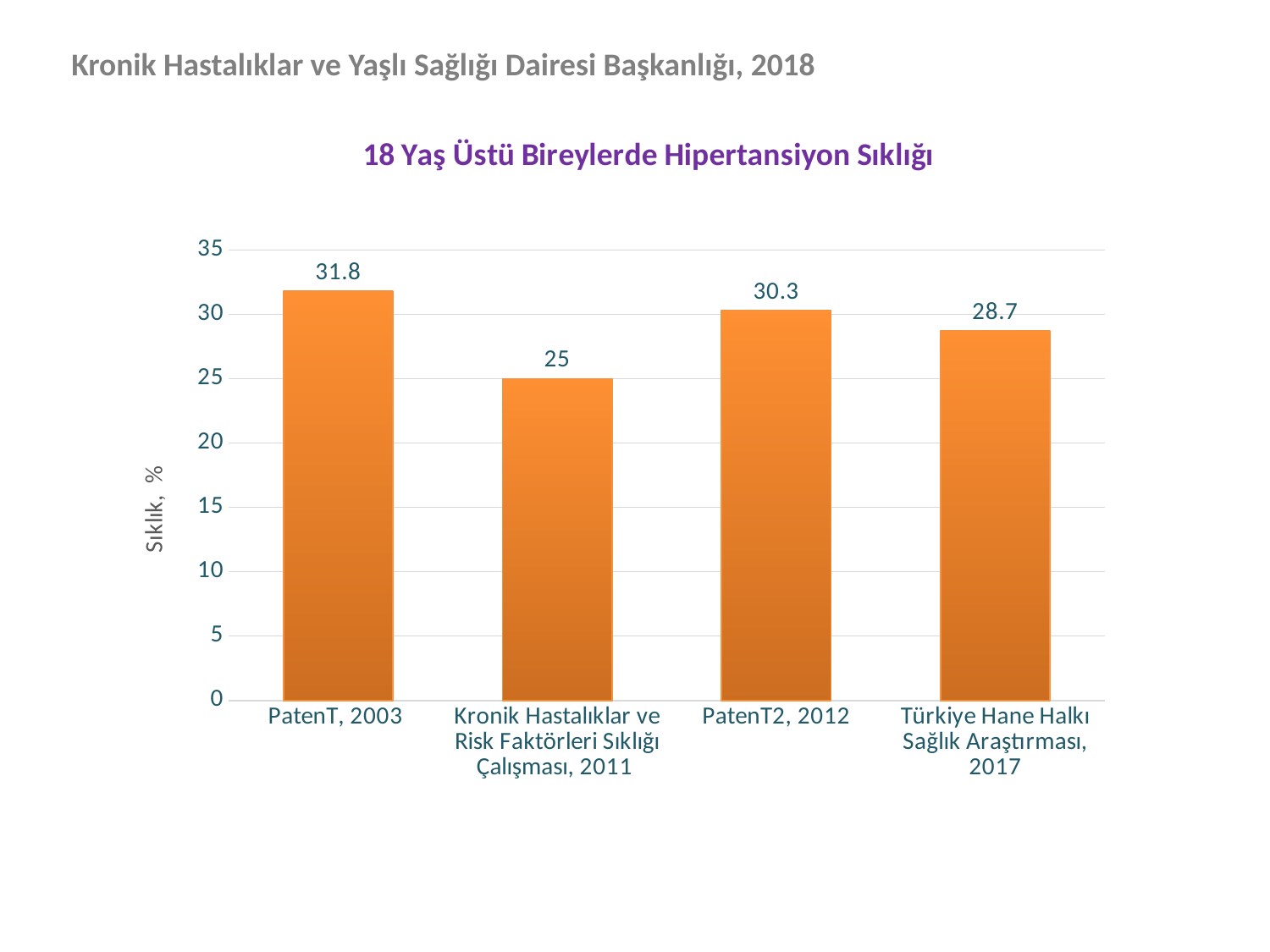
What is the value for Türkiye Hane Halkı Sağlık Araştırması, 2017? 28.7 Which is larger, the value for PatenT2, 2012 or the value for Türkiye Hane Halkı Sağlık Araştırması, 2017? PatenT2, 2012 What is the value for Kronik Hastalıklar ve Risk Faktörleri Sıklığı Çalışması, 2011? 25 What is the value for PatenT, 2003? 31.8 Which category has the highest value? PatenT, 2003 What is the title of the chart? 18 Yaş Üstü Bireylerde Hipertansiyon Sıklığı What kind of chart is shown on the slide? bar chart Which category has the lowest value? Kronik Hastalıklar ve Risk Faktörleri Sıklığı Çalışması, 2011 What is the value for PatenT2, 2012? 30.3 What is the difference between the values for PatenT, 2003 and PatenT2, 2012? 1.5 How many categories are shown in the chart? 4 Is the value for Türkiye Hane Halkı Sağlık Araştırması, 2017 greater or less than 30? less